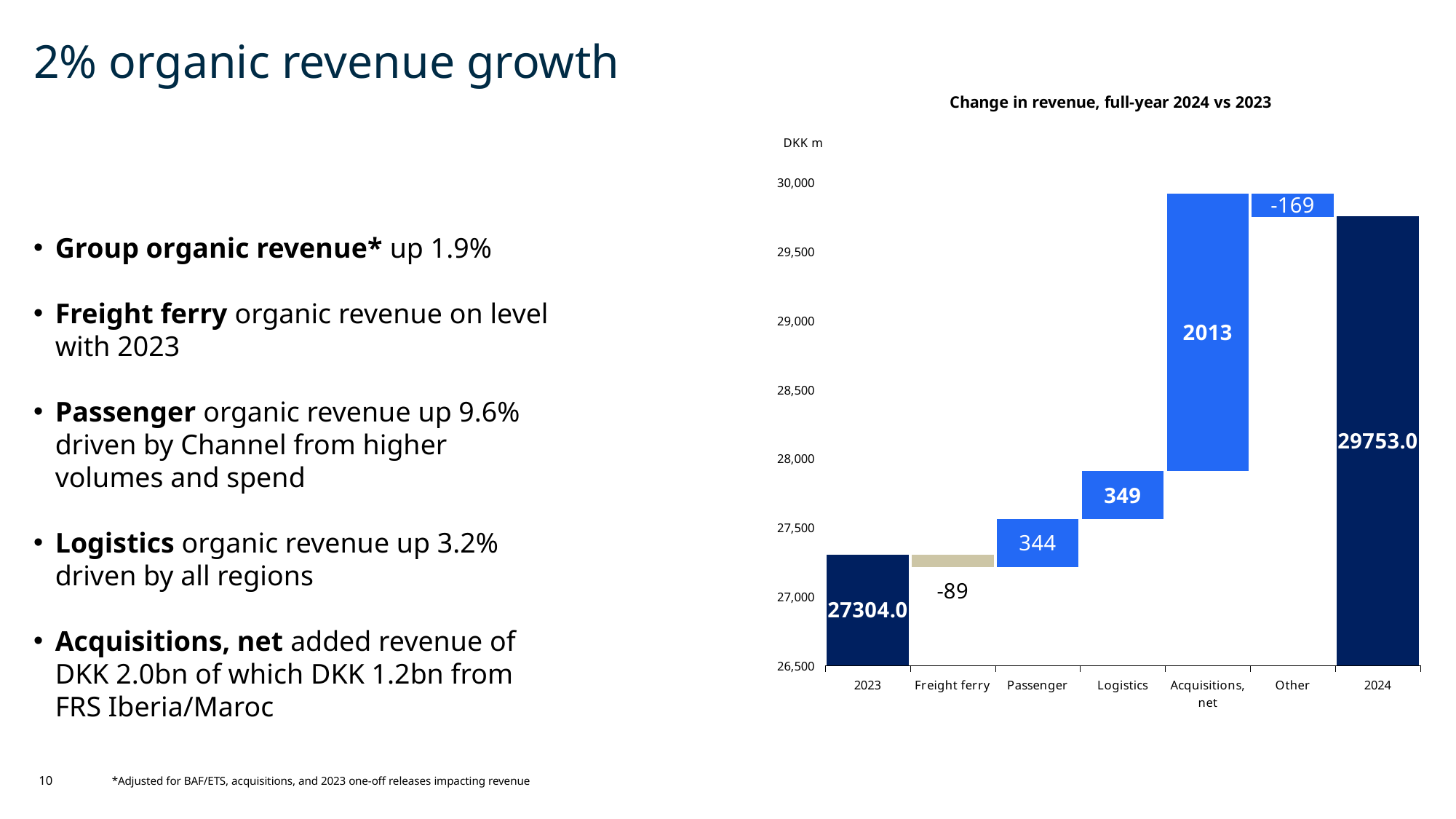
Which category contributes the largest positive change in revenue? Acquisitions, net Which contributes more to the change in revenue, Passenger or Logistics? Logistics What is the change in revenue attributed to Acquisitions, net? 2013 What is the revenue value shown for 2024 in the chart? 29753.0 How many categories are shown on the x axis of the chart? 7 What is the revenue value shown for 2023 in the chart? 27304.0 By how much did revenue increase from 2023 (27304.0) to 2024 (29753.0)? 2449.0 Which category shows the most negative change in revenue? Other What is the difference between the Logistics change (349) and the Passenger change (344)? 5 What is the change in revenue attributed to Freight ferry? -89 What is the title of the chart? Change in revenue, full-year 2024 vs 2023 What is the change in revenue attributed to Other? -169